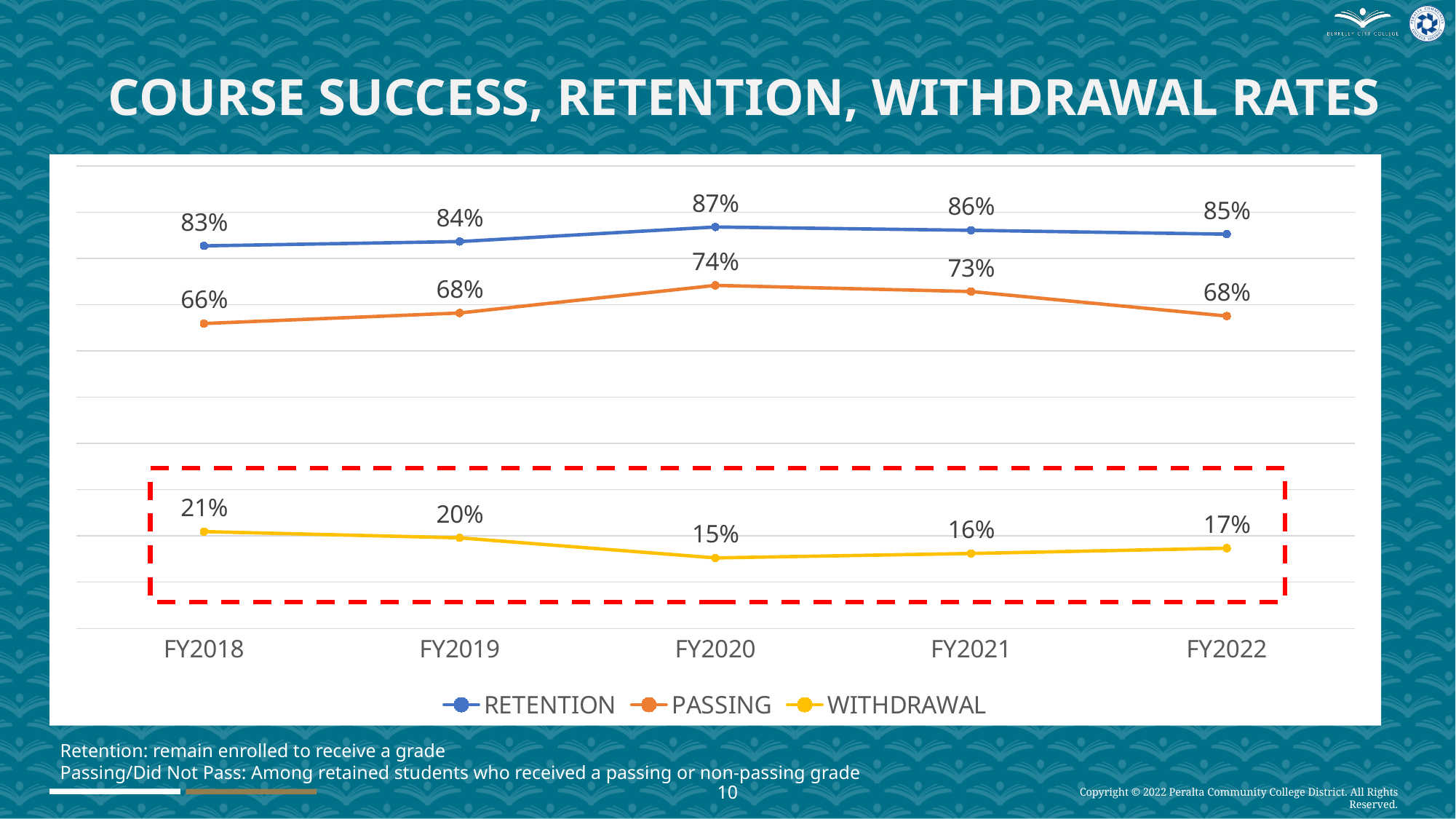
How many series does the legend list? 3 What kind of chart is shown on the slide? Line chart What is the RETENTION rate for FY2020? 87% What is the WITHDRAWAL rate for FY2022? 17% Which is larger, the WITHDRAWAL rate in FY2018 or in FY2021? FY2018 In which fiscal year is the WITHDRAWAL rate lowest? FY2020 What is the PASSING rate for FY2018? 66% Does the WITHDRAWAL rate rise or fall from FY2018 to FY2020? Fall How many fiscal years are shown on the x axis? 5 In which fiscal year is the PASSING rate highest? FY2020 What is the difference between the RETENTION rate and the PASSING rate in FY2022? 17% Which series is drawn in yellow? WITHDRAWAL